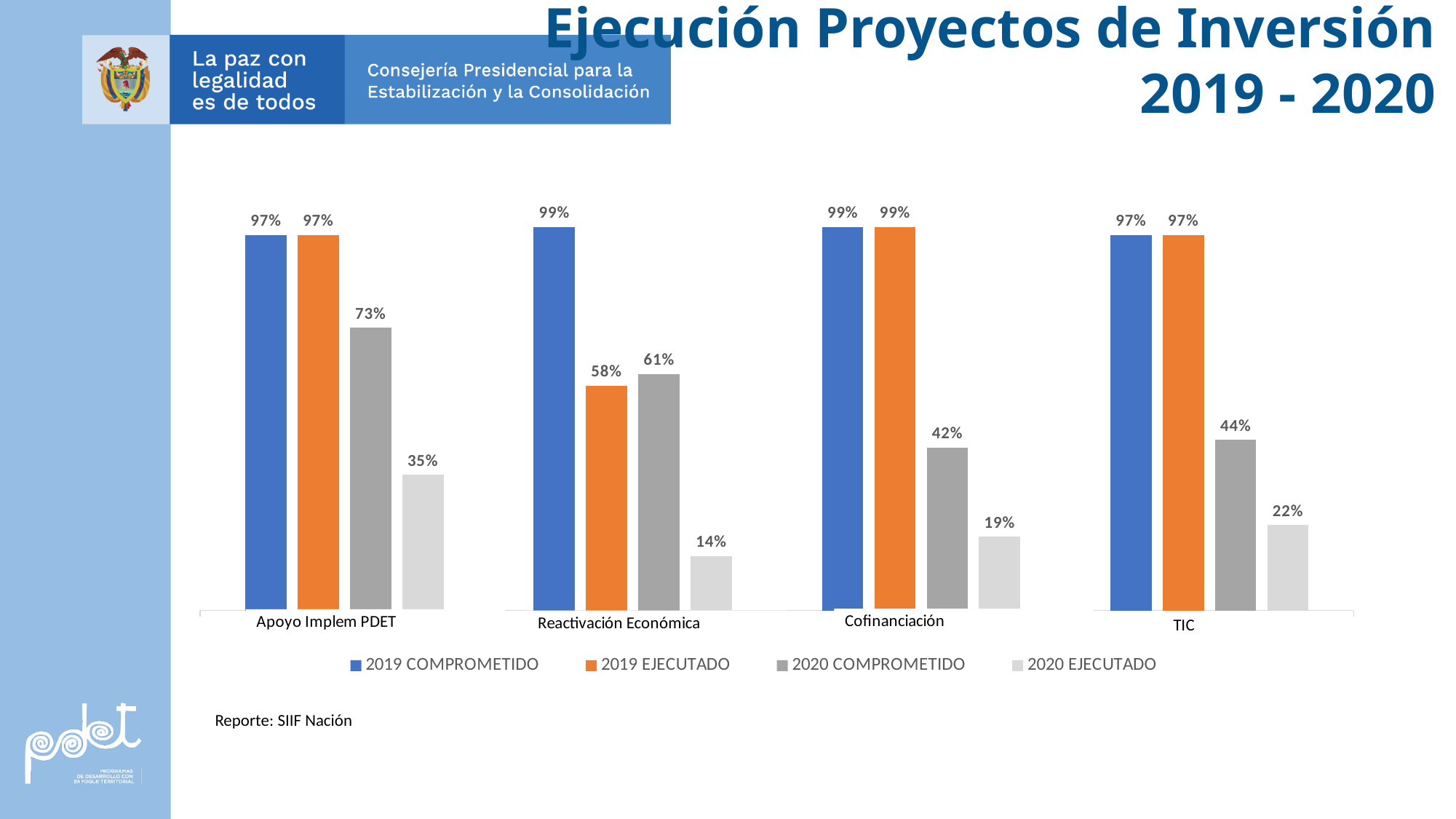
Which category has the highest 2020 COMPROMETIDO value? Apoyo Implem PDET Which category has the lowest 2020 EJECUTADO value? Reactivación Económica How many series does the legend list? 4 What is the 2019 EJECUTADO value for Reactivación Económica? 58% What is the difference between the 2020 COMPROMETIDO and 2020 EJECUTADO values for TIC? 22% Which is larger for Reactivación Económica: 2019 EJECUTADO or 2020 COMPROMETIDO? 2020 COMPROMETIDO What is the 2020 COMPROMETIDO value for Cofinanciación? 42% What kind of chart is shown on the slide? Bar chart Which series is shown in orange in the legend? 2019 EJECUTADO What is the 2020 EJECUTADO value for Apoyo Implem PDET? 35% How many categories are shown on the x axis? 4 What is the 2019 COMPROMETIDO value for TIC? 97%